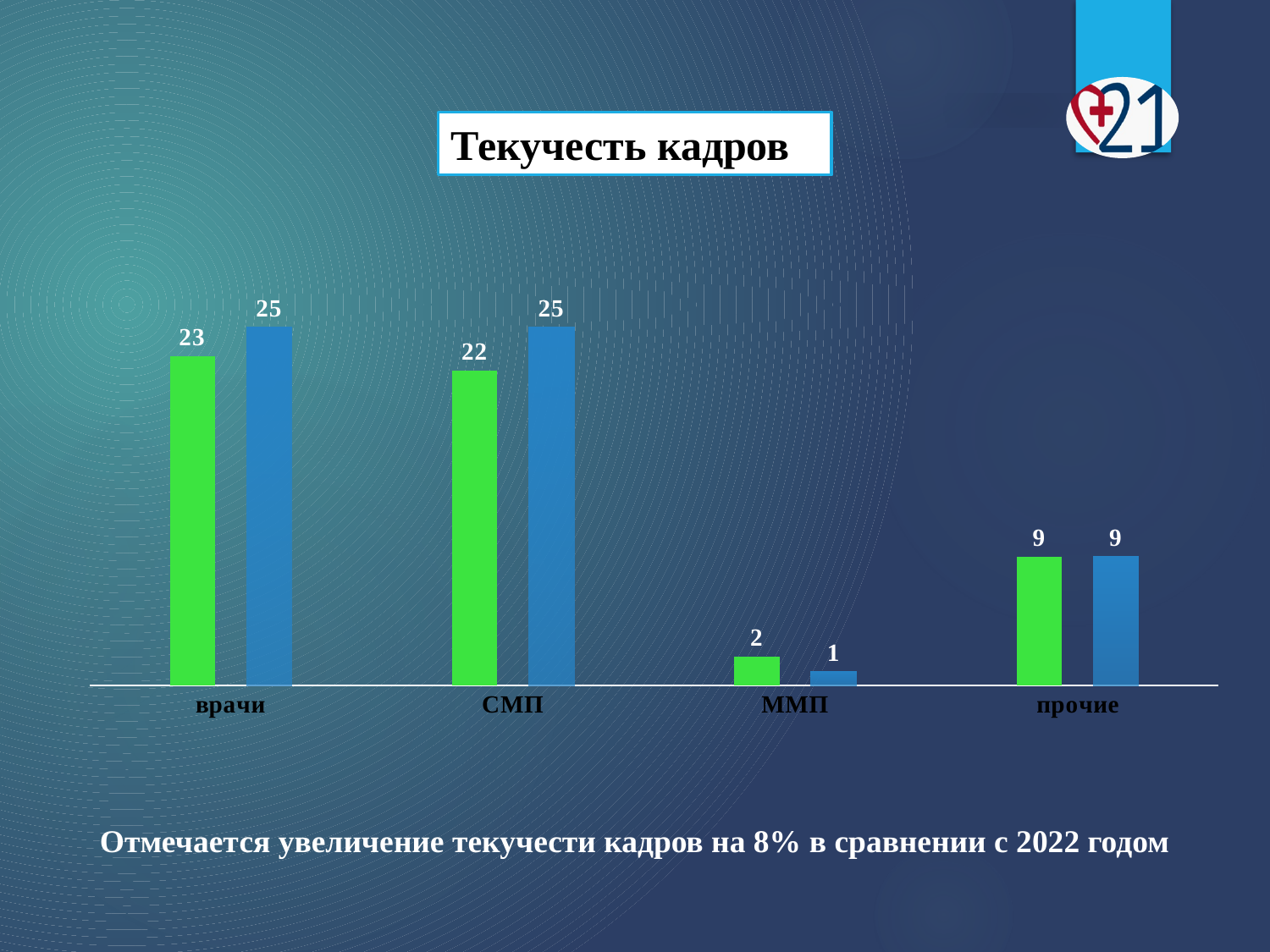
What is the value of the green bar for ММП? 2 Which category has the lowest blue bar? ММП What is the difference between the blue and green bars for СМП? 3 What is the value of the green bar for врачи? 23 How many categories are shown on the x axis? 4 Which category has the highest green bar? врачи What is the value of the blue bar for прочие? 9 What is the title of the chart? Текучесть кадров What is the difference between the green bars for врачи and прочие? 14 What is the value of the blue bar for СМП? 25 Which is larger for ММП, the green bar or the blue bar? green bar What type of chart is shown on the slide? bar chart